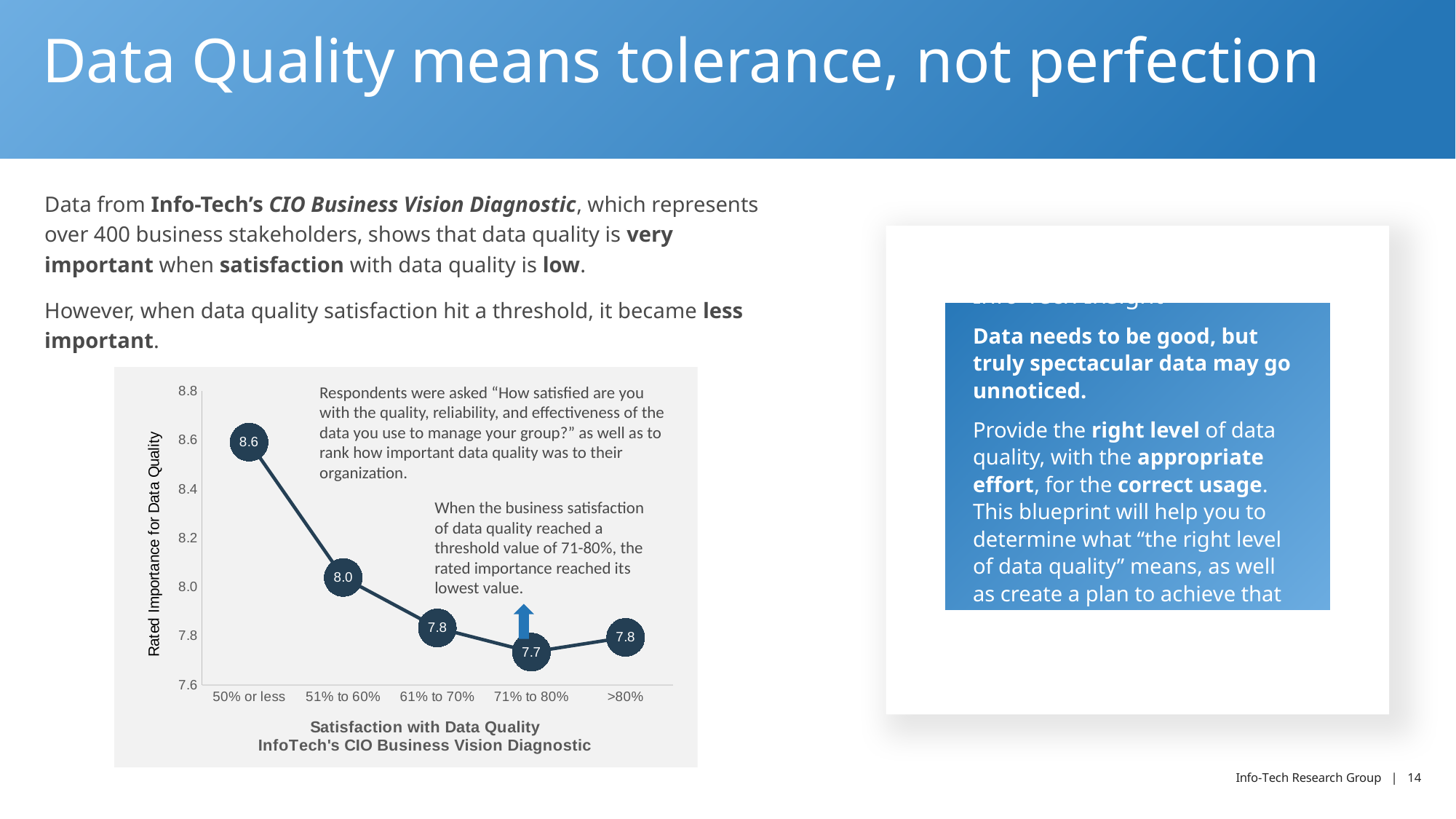
Which has a higher rated importance: 51% to 60% or 61% to 70%? 51% to 60% Which satisfaction category has the highest rated importance for data quality? 50% or less Does the rated importance generally rise or fall as satisfaction with data quality increases from 50% or less to 71% to 80%? Fall How many satisfaction categories are plotted on the x axis? 5 What kind of chart is shown on the slide? Line chart What is the label of the chart's y axis? Rated Importance for Data Quality What is the difference in rated importance between the 50% or less category and the 71% to 80% category? 0.9 What is the rated importance for data quality for the 51% to 60% satisfaction category? 8.0 What is the rated importance for data quality for the >80% satisfaction category? 7.8 Which satisfaction category has the lowest rated importance for data quality? 71% to 80% What is the rated importance for data quality when satisfaction is 50% or less? 8.6 What is the rated importance for data quality for the 71% to 80% satisfaction category? 7.7